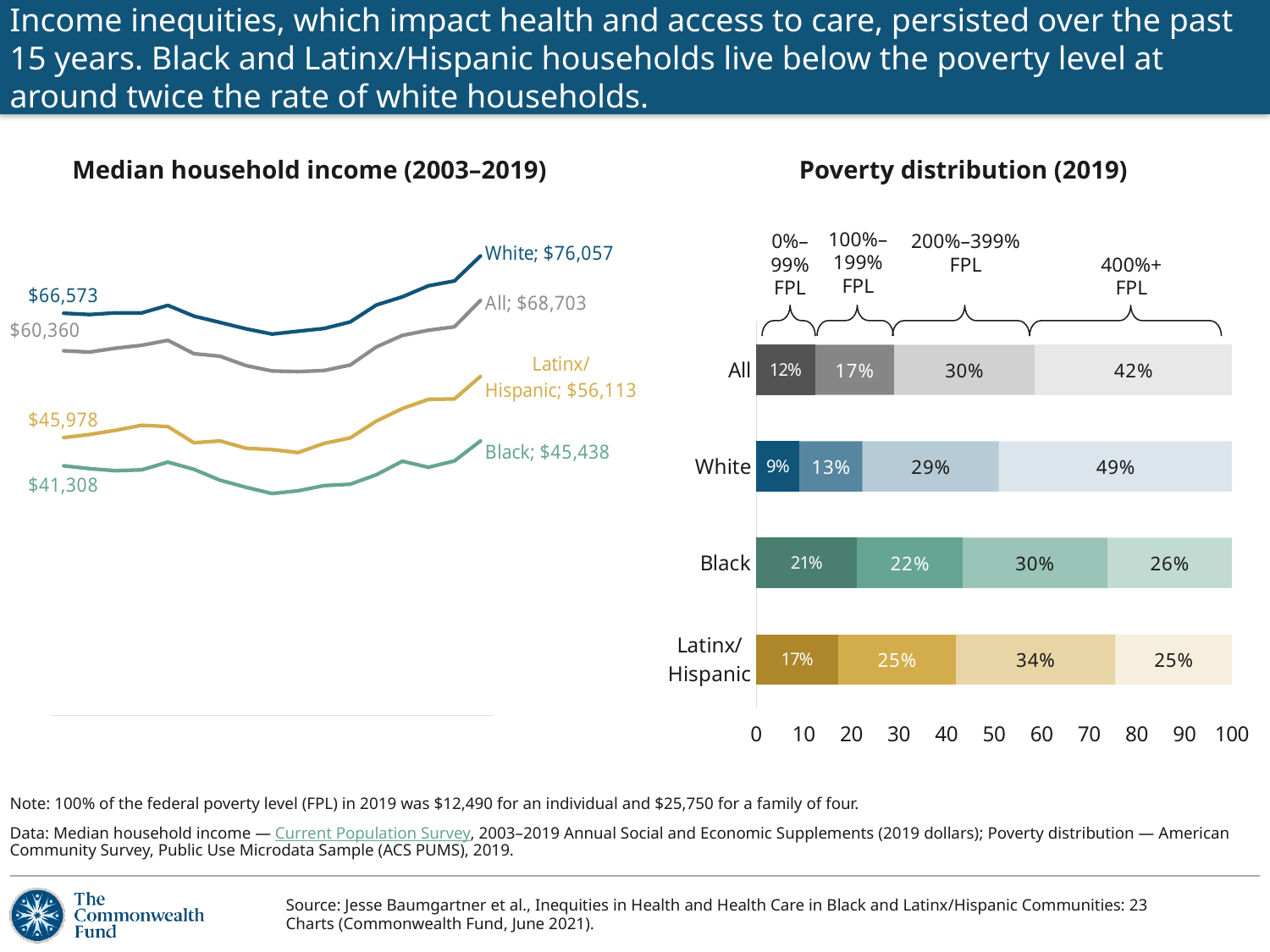
In the Median household income (2003–2019) chart, what is the 2019 median household income for White households? $76,057 In the Median household income (2003–2019) chart, what is the difference between the 2019 median income of White households and Black households? $30,619 In the Median household income (2003–2019) chart, does the median income for Latinx/Hispanic households rise or fall from 2003 to 2019 overall? rise In the Poverty distribution (2019) chart, which group has the highest share at 400%+ FPL? White In the Poverty distribution (2019) chart, what is the combined share of Latinx/Hispanic households below 200% FPL (0%–99% plus 100%–199%)? 42% What kind of chart is the Median household income (2003–2019) chart? line chart In the Poverty distribution (2019) chart, what share of Black households are at 0%–99% FPL? 21% How many groups are shown as bars in the Poverty distribution (2019) chart? 4 In the Median household income (2003–2019) chart, what was the median household income for Black households at the start of the series? $41,308 In the Poverty distribution (2019) chart, is the 200%–399% FPL share larger for Latinx/Hispanic or for Black households? Latinx/Hispanic In the Median household income (2003–2019) chart, which group has the lowest median household income in 2019? Black In the Poverty distribution (2019) chart, what share of White households are at 400%+ FPL? 49%